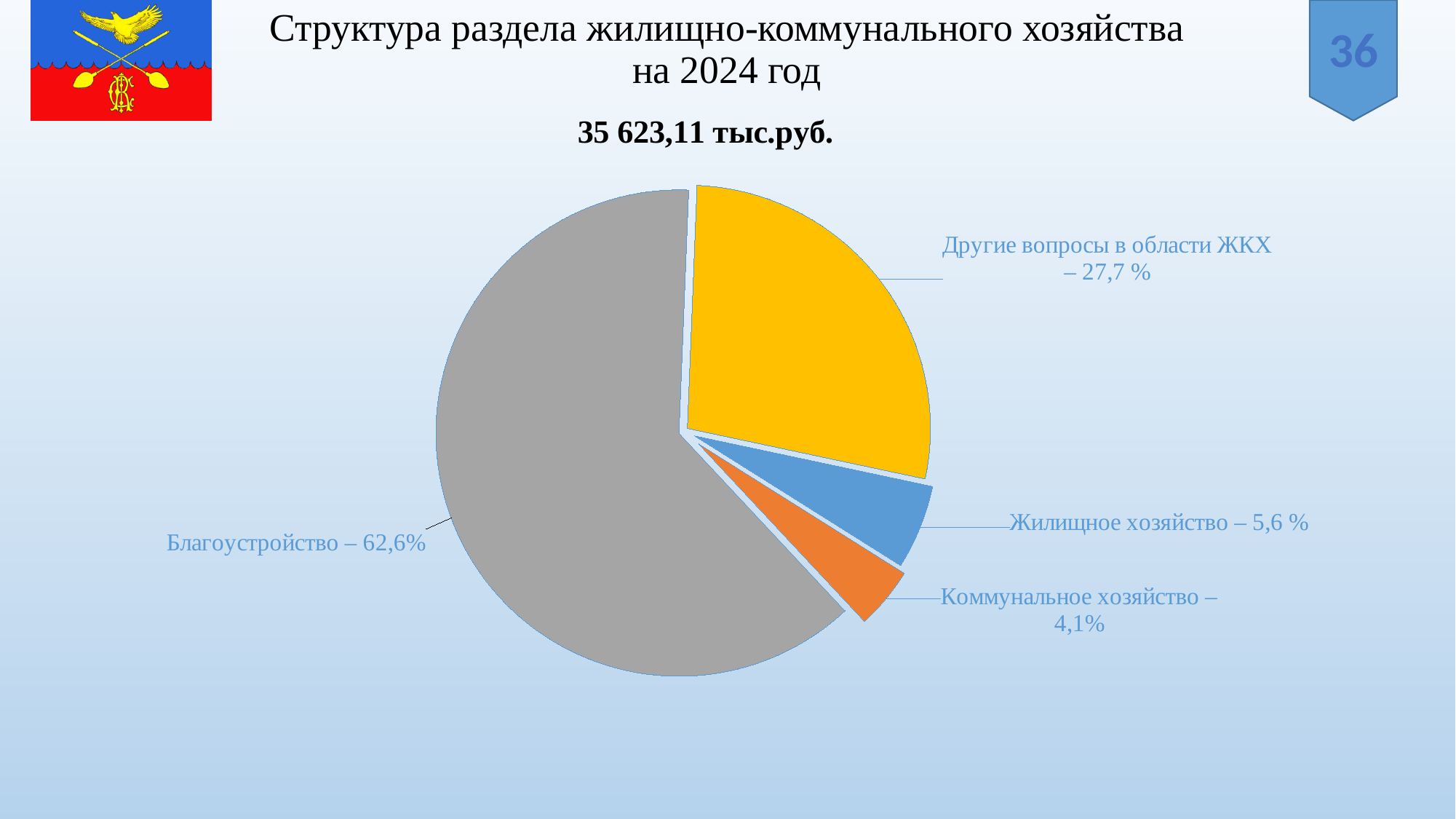
What share of the pie does Жилищное хозяйство have? 5,6 % What is the difference in percentage points between the shares of Благоустройство and Другие вопросы в области ЖКХ? 34,9 Which category has the smallest slice of the pie? Коммунальное хозяйство What kind of chart is shown on the slide? pie chart What total amount in тыс.руб. is shown above the pie chart? 35 623,11 тыс.руб. What share of the pie does Другие вопросы в области ЖКХ have? 27,7 % What share of the pie does Благоустройство have? 62,6% What colour is the slice for Благоустройство? grey Which category has the largest slice of the pie? Благоустройство How many slices does the pie chart have? 4 Which is larger, the share for Жилищное хозяйство or the share for Коммунальное хозяйство? Жилищное хозяйство